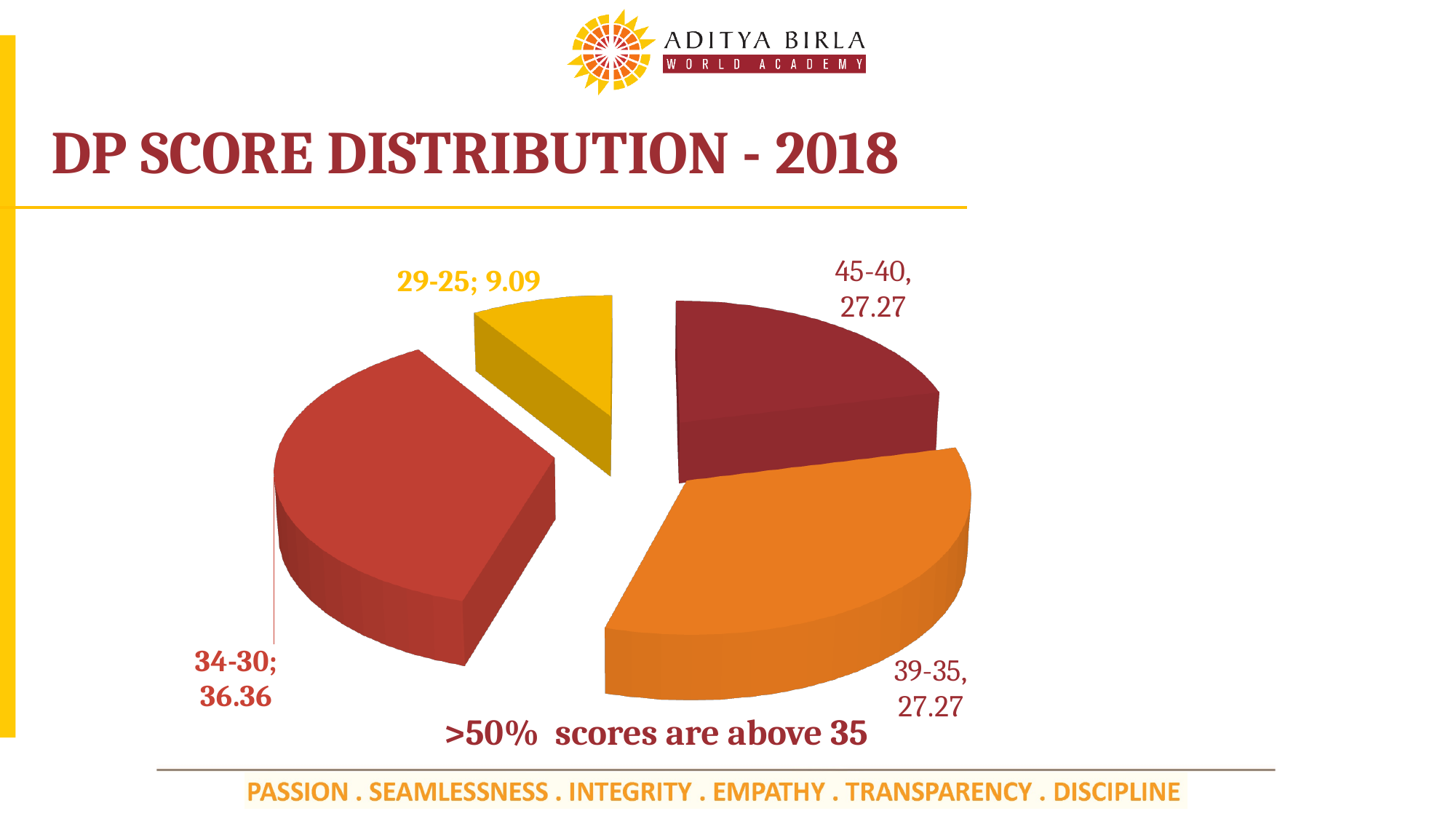
What is the title of the chart? DP SCORE DISTRIBUTION - 2018 What is the value for the 29-25 score range? 9.09 Which score range has the smallest share of the pie? 29-25 Which is larger, the value for 34-30 or the value for 45-40? 34-30 Which score range has the largest share of the pie? 34-30 What kind of chart is shown on the slide? Pie chart How many score ranges (slices) does the pie chart show? 4 What colour is the slice for the 29-25 score range? Yellow What is the value for the 34-30 score range? 36.36 What is the value for the 39-35 score range? 27.27 What is the difference between the values for 34-30 and 29-25? 27.27 What is the value for the 45-40 score range? 27.27